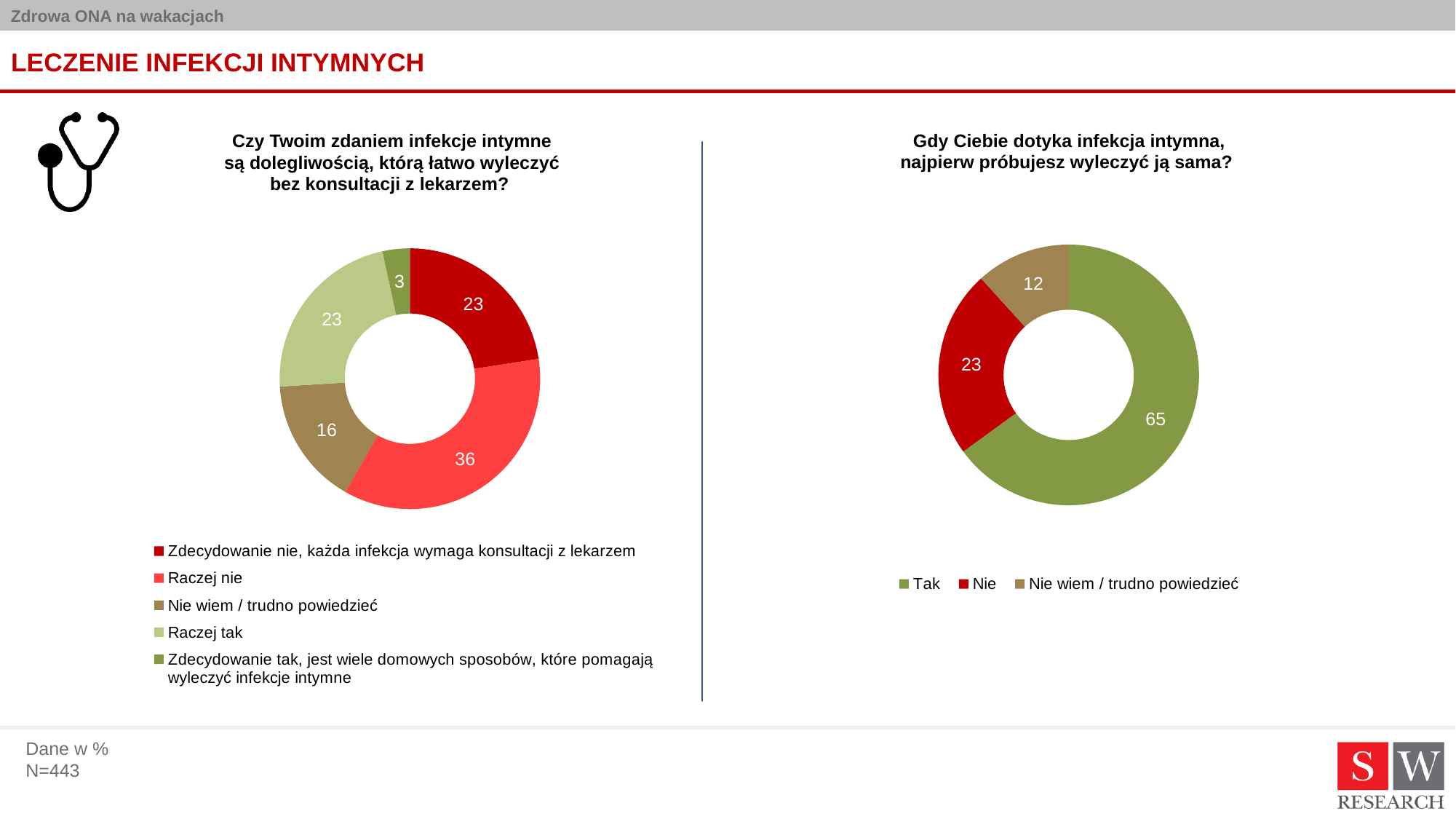
In the right chart, what colour is the "Tak" slice? Green In the right chart, what is the value for "Nie wiem / trudno powiedzieć"? 12 In the left chart, which category has the largest share? Raczej nie In the left chart, what is the difference between "Raczej nie" and "Nie wiem / trudno powiedzieć"? 20 In the left chart, how many categories does the legend list? 5 In the right chart, which is larger, "Nie" or "Nie wiem / trudno powiedzieć"? Nie In the left chart, which category has the smallest share? Zdecydowanie tak, jest wiele domowych sposobów, które pomagają wyleczyć infekcje intymne In the left chart ("Czy Twoim zdaniem infekcje intymne są dolegliwością, którą łatwo wyleczyć bez konsultacji z lekarzem?"), what is the value for "Raczej nie"? 36 In the right chart ("Gdy Ciebie dotyka infekcja intymna, najpierw próbujesz wyleczyć ją sama?"), what is the value for "Tak"? 65 What kind of chart is the right chart? Doughnut (pie) chart In the right chart, what is the difference between "Tak" and "Nie"? 42 In the left chart, what is the value for "Zdecydowanie tak, jest wiele domowych sposobów, które pomagają wyleczyć infekcje intymne"? 3